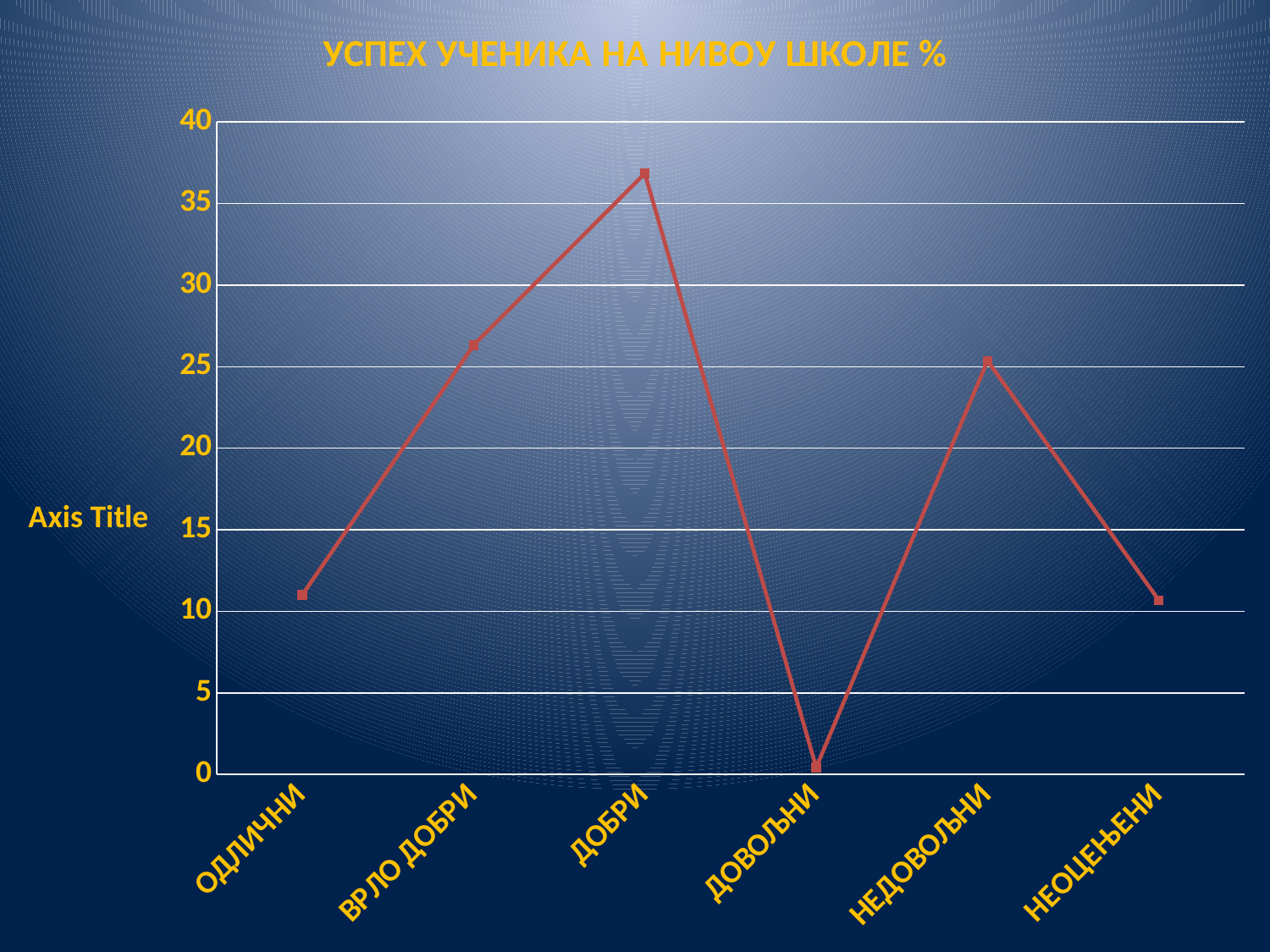
How many categories are plotted along the x axis? 6 Which category has the lowest value? ДОВОЉНИ Is the value for ВРЛО ДОБРИ greater or less than 20? greater Is the value for НЕОЦЕЊЕНИ greater or less than 15? less What type of chart is shown on the slide? line chart Is the value for НЕДОВОЉНИ greater or less than 20? greater What is the title of the chart? УСПЕХ УЧЕНИКА НА НИВОУ ШКОЛЕ % Do the values rise or fall from ОДЛИЧНИ to ДОБРИ? rise Which is larger, the value for ДОБРИ or the value for ОДЛИЧНИ? ДОБРИ Which category has the highest value? ДОБРИ